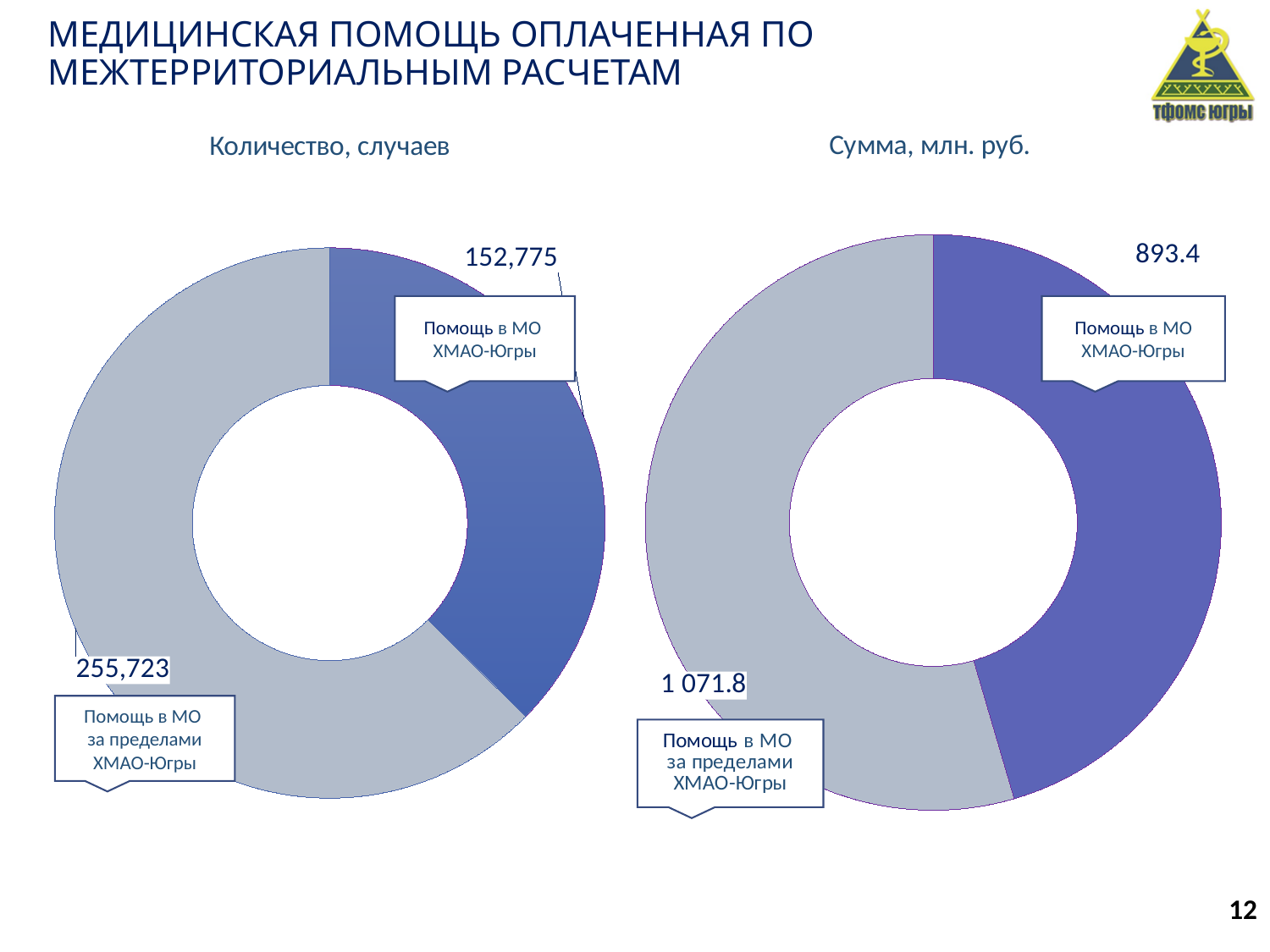
How many charts are on the slide? 2 In the 'Сумма, млн. руб.' chart, what is the value for 'Помощь в МО за пределами ХМАО-Югры'? 1 071.8 In the 'Количество, случаев' chart, what is the value for 'Помощь в МО за пределами ХМАО-Югры'? 255,723 In the 'Сумма, млн. руб.' chart, what is the value for 'Помощь в МО ХМАО-Югры'? 893.4 In the 'Количество, случаев' chart, what is the value for 'Помощь в МО ХМАО-Югры'? 152,775 In the 'Количество, случаев' chart, what is the difference between the two categories? 102,948 In the 'Сумма, млн. руб.' chart, which category has the smaller value? Помощь в МО ХМАО-Югры What type of chart is used on the left side of the slide ('Количество, случаев')? Donut (pie) chart In the 'Количество, случаев' chart, which category has the larger value? Помощь в МО за пределами ХМАО-Югры How many categories does the 'Сумма, млн. руб.' chart show? 2 In the 'Сумма, млн. руб.' chart, what is the total of the two slices? 1 965.2 In the 'Сумма, млн. руб.' chart, what is the difference between the two categories? 178.4